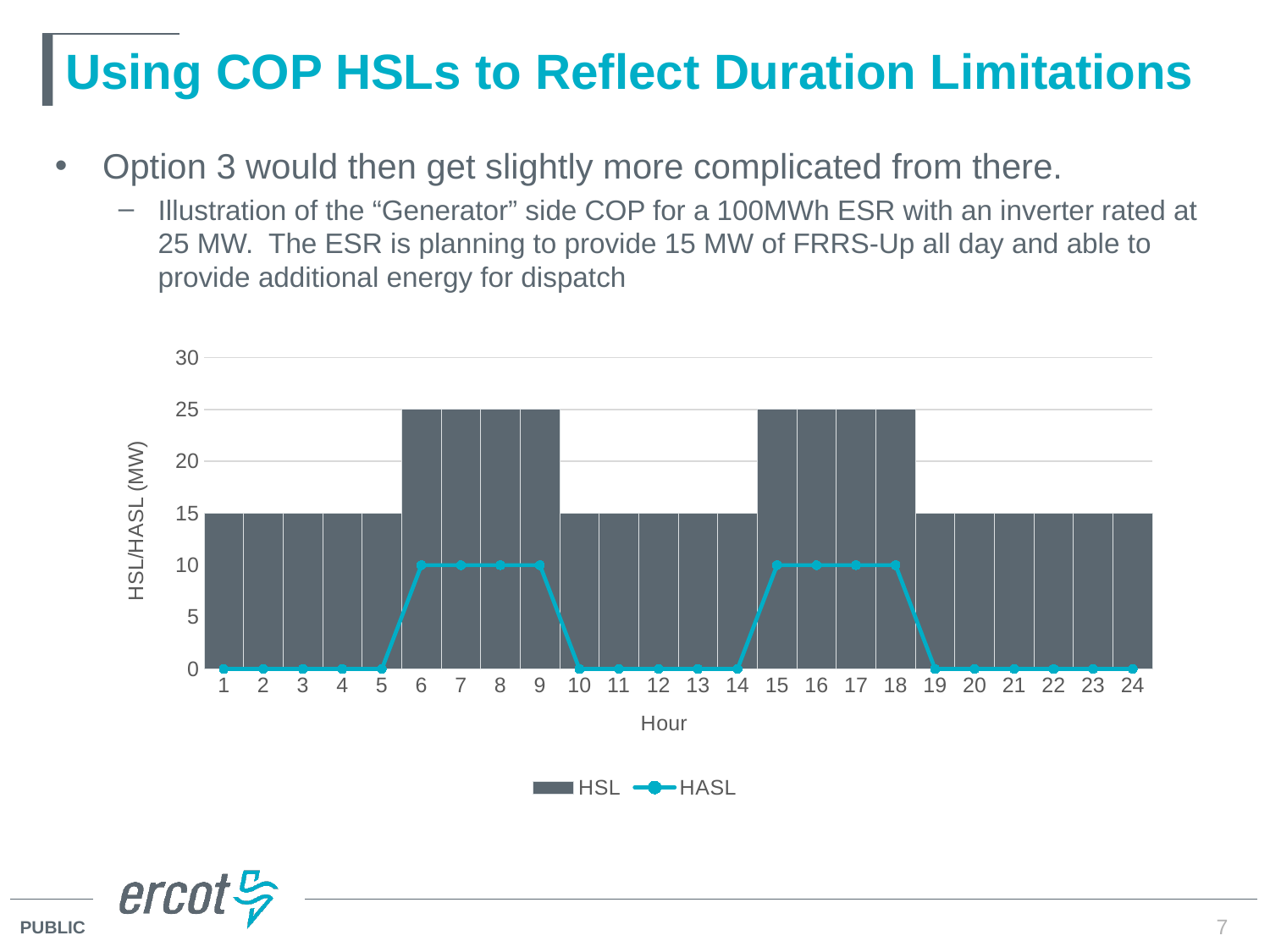
What is the HASL value at hour 3? 0 What are the two series named in the chart legend? HSL and HASL What is the HASL value at hour 16? 10 What is the HSL value at hour 12? 15 What kind of chart is shown on the slide? A combined bar and line chart Which is larger at hour 15, the HSL value or the HASL value? HSL How many series does the chart legend list? 2 Is the HSL value at hour 20 greater or less than 20? less What is the difference between the HSL and HASL values at hour 8? 15 How many hours are plotted along the x axis of the chart? 24 What is the label on the y axis of the chart? HSL/HASL (MW) What is the HSL value at hour 7? 25